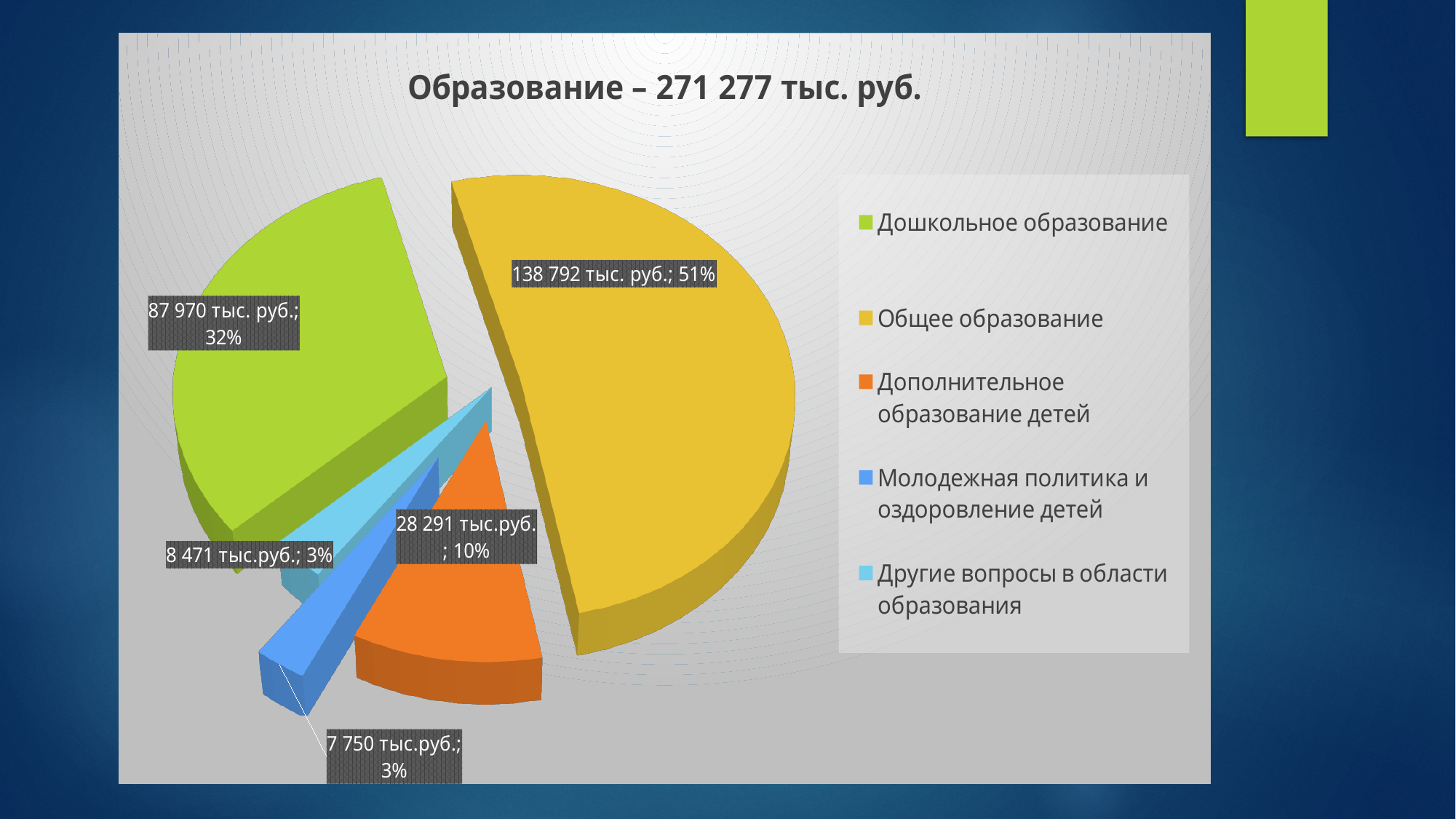
What kind of chart is shown on the slide? Pie chart What is the title of the chart? Образование – 271 277 тыс. руб. What is the value for Дошкольное образование? 87 970 тыс. руб. What share of the pie does Общее образование represent? 51% What is the value for Общее образование? 138 792 тыс. руб. How many slices does the pie chart have? 5 What is the value for Дополнительное образование детей? 28 291 тыс.руб. Which is larger, Дополнительное образование детей or Другие вопросы в области образования? Дополнительное образование детей What is the difference between the values for Общее образование and Дошкольное образование? 50 822 тыс. руб. What share of the pie does Дошкольное образование represent? 32% What is the value for Молодежная политика и оздоровление детей? 7 750 тыс.руб. Which category has the largest slice? Общее образование